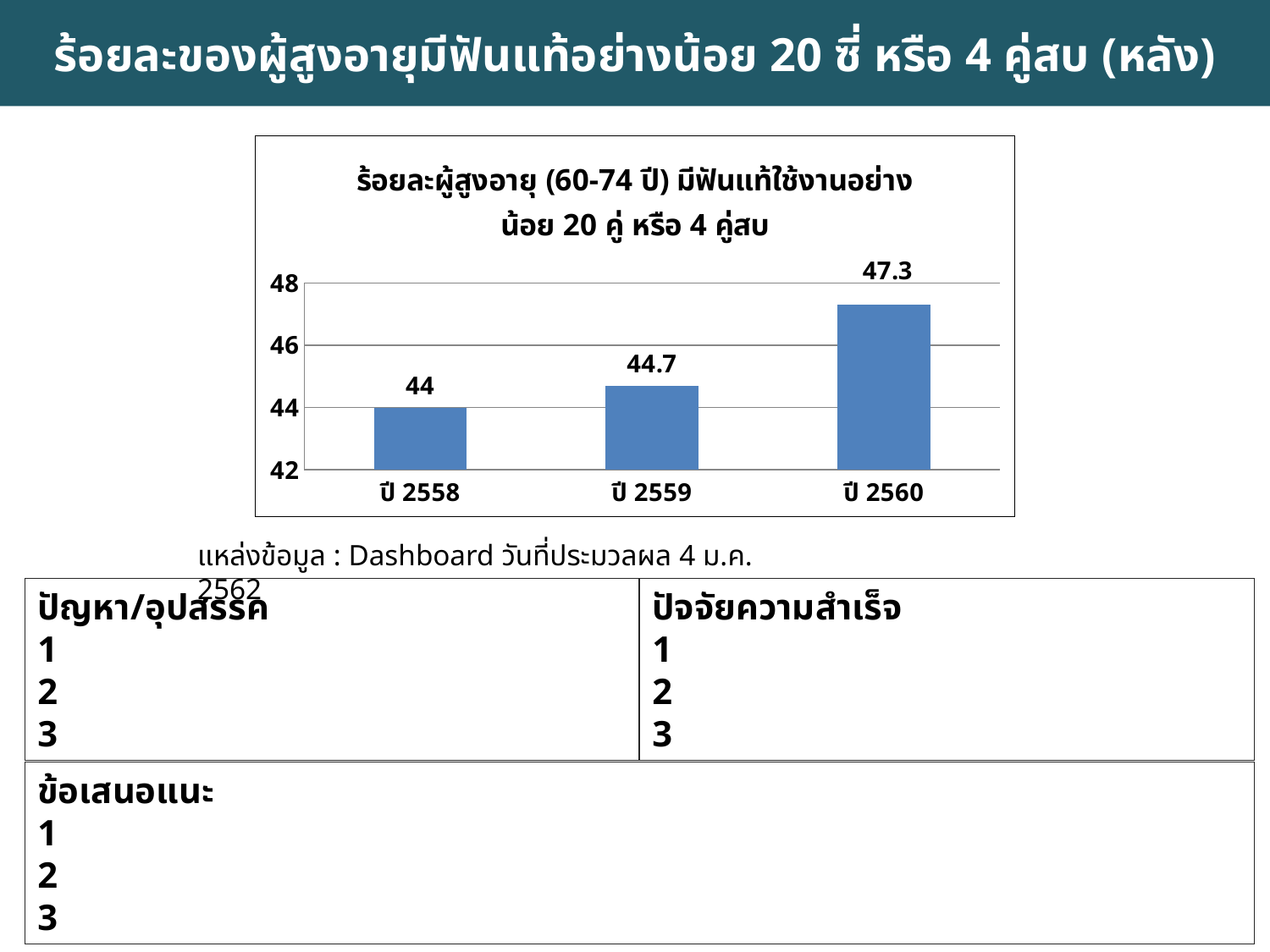
How many years are shown on the x axis? 3 Which year has the highest value? ปี 2560 What is the difference between the values for ปี 2559 and ปี 2558? 0.7 What is the difference between the values for ปี 2560 and ปี 2558? 3.3 What kind of chart is shown? bar chart What is the value for ปี 2558? 44 What is the value for ปี 2560? 47.3 Which year has the lowest value? ปี 2558 Which is larger, the value for ปี 2559 or ปี 2560? ปี 2560 Is the value for ปี 2560 greater or less than 46? greater What is the value for ปี 2559? 44.7 Do the values rise or fall from ปี 2558 to ปี 2560? rise